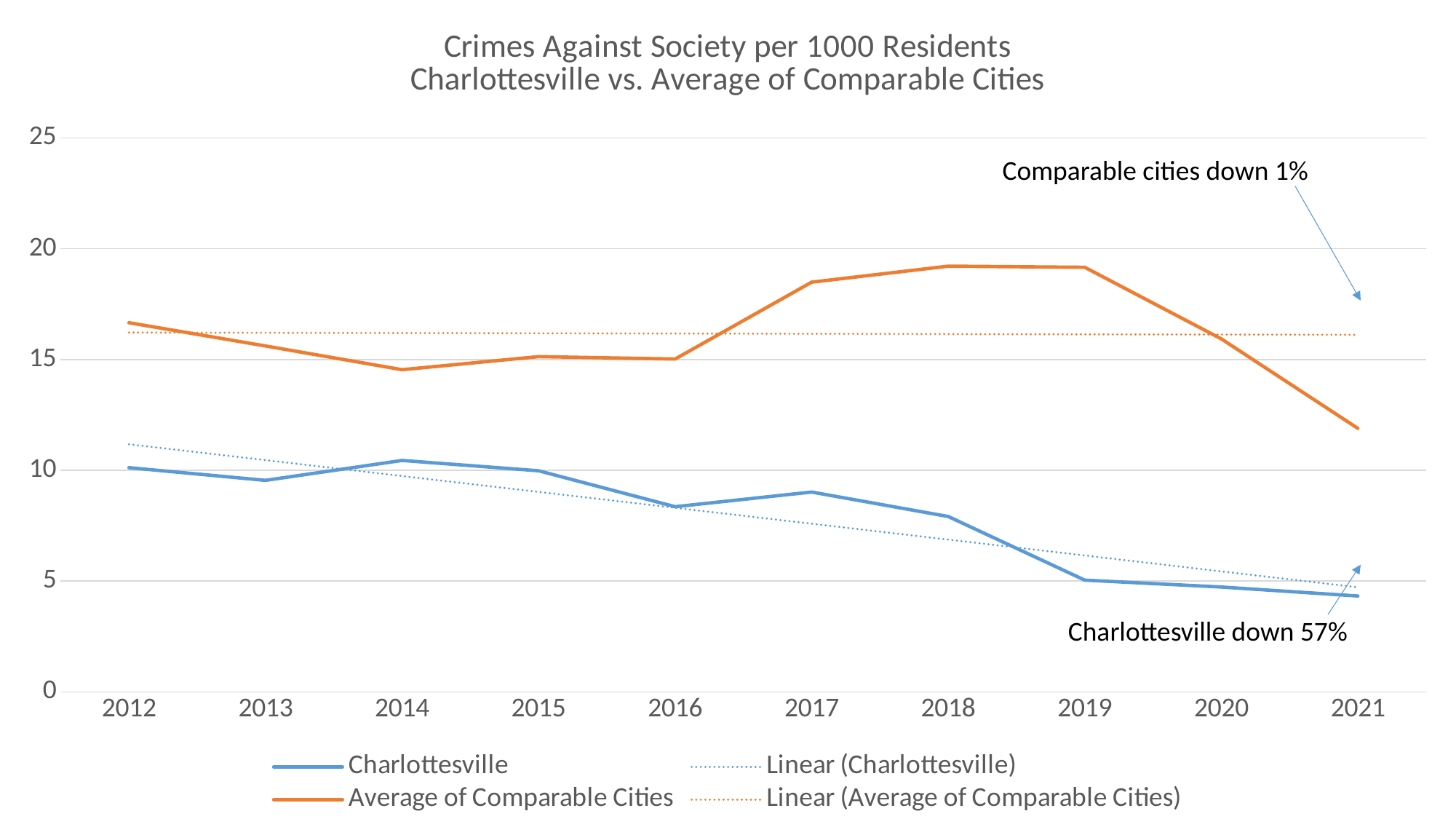
According to the annotation on the chart, by what percentage is Charlottesville down? 57% How many entries does the legend list? 4 Is the Average of Comparable Cities value for 2018 greater or less than 15? greater What kind of chart is shown on the slide? line chart How many years are plotted along the x axis? 10 In 2017, which series has the larger value, Charlottesville or Average of Comparable Cities? Average of Comparable Cities Is the Average of Comparable Cities value for 2021 greater or less than 15? less Does the Charlottesville line generally rise or fall from 2012 to 2021? fall According to the annotation on the chart, by what percentage are comparable cities down? 1% Is the Charlottesville value for 2021 greater or less than 5? less Which year has the lowest value for Average of Comparable Cities? 2021